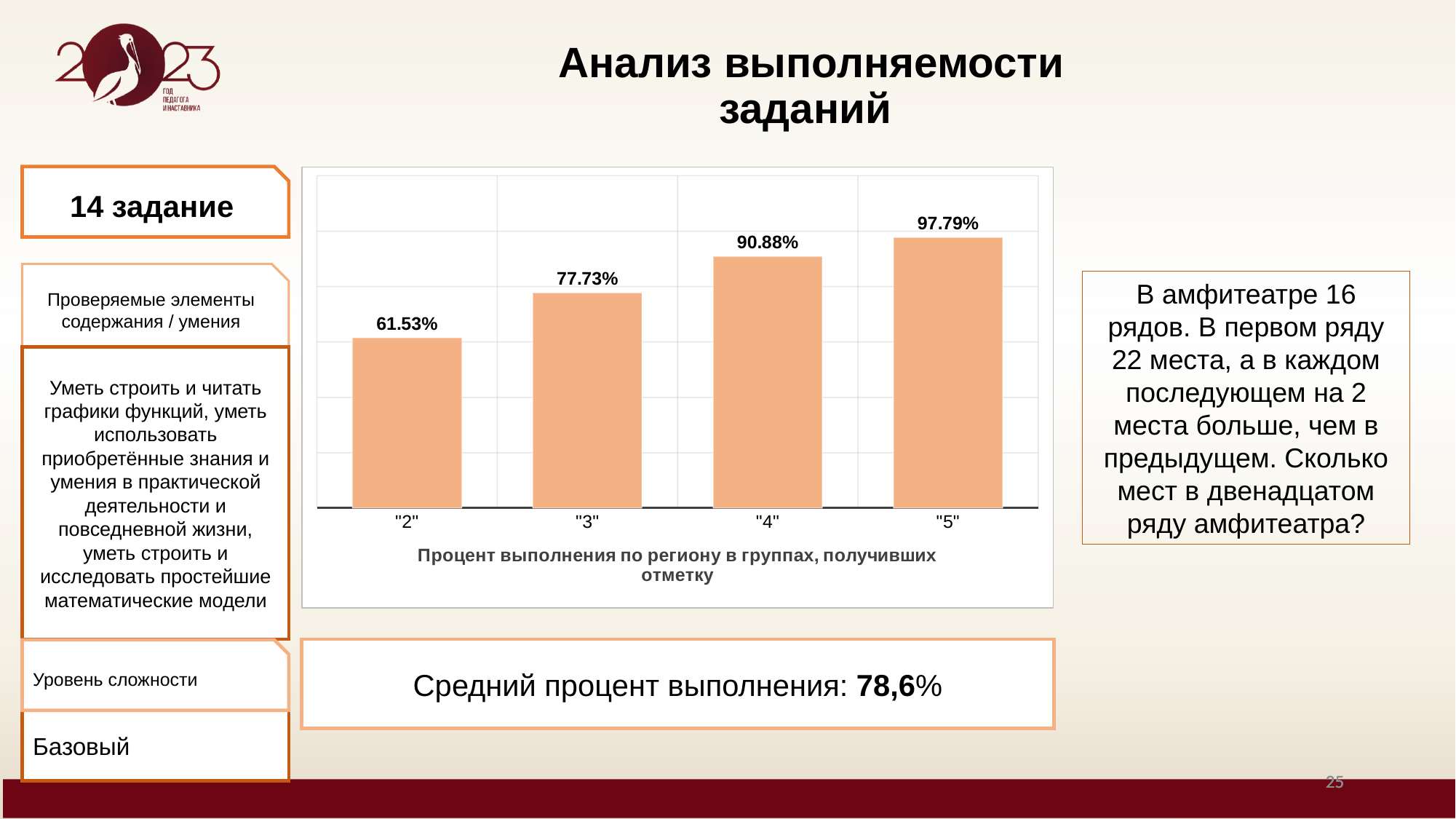
Do the completion percentages rise or fall as the mark increases from "2" to "5"? Rise What is the completion percentage for the group that received mark "5"? 97.79% What is the difference in completion percentage between the "4" group and the "3" group? 13.15% What is the completion percentage for the group that received mark "2"? 61.53% What is the difference in completion percentage between the "5" group and the "2" group? 36.26% What is the completion percentage for the group that received mark "4"? 90.88% What type of chart is shown on the slide? Bar chart Which group has a higher completion percentage, "3" or "4"? "4" Which mark group has the highest completion percentage? "5" Which mark group has the lowest completion percentage? "2" What is the completion percentage for the group that received mark "3"? 77.73% How many mark groups are shown in the chart? 4